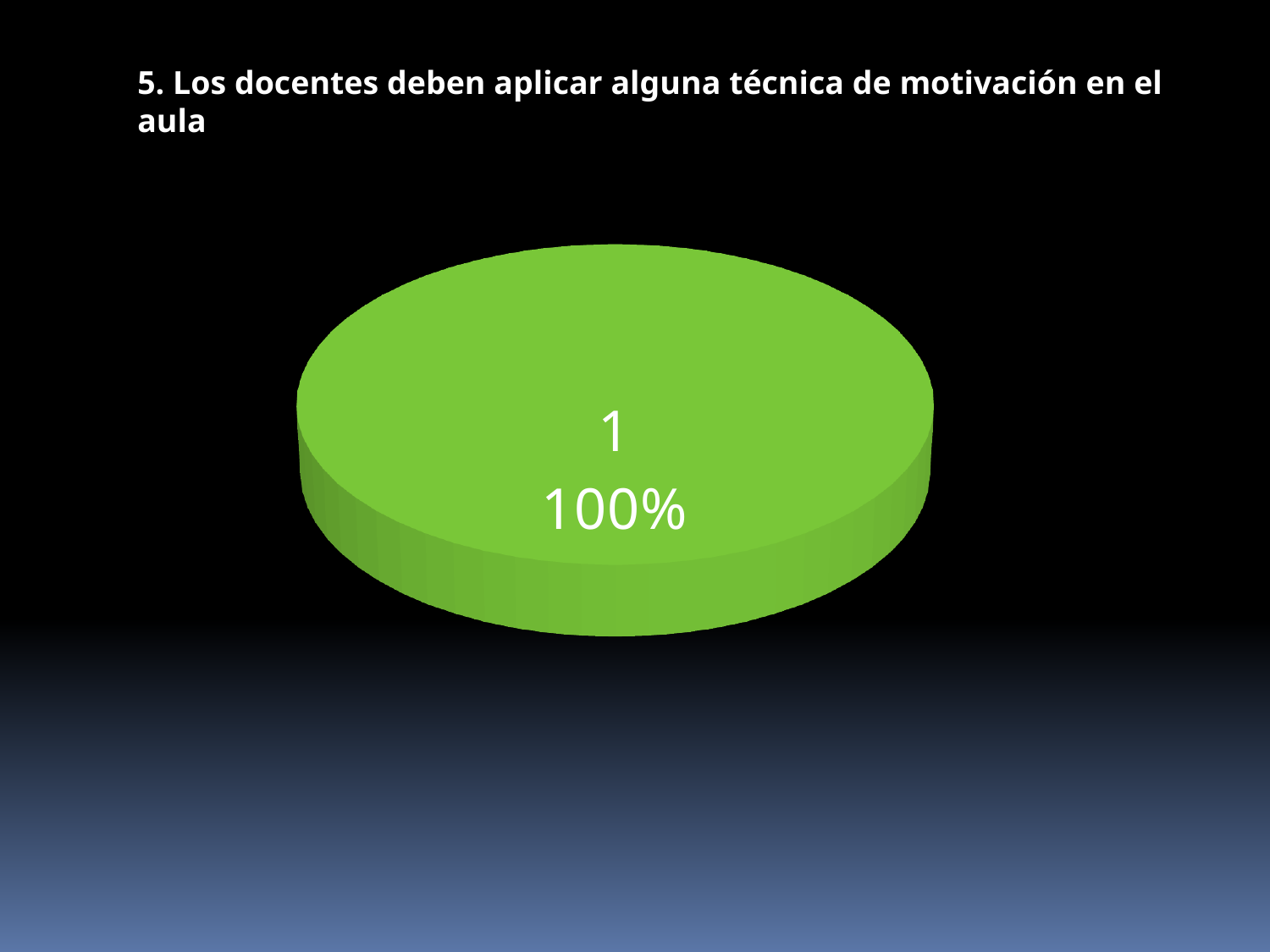
What percentage is printed on the pie chart's slice? 100% What is the title of the chart on the slide? 5. Los docentes deben aplicar alguna técnica de motivación en el aula What kind of chart is shown on the slide? pie chart How many slices does the pie chart have? 1 What category label is printed on the pie chart's slice? 1 What colour is the slice of the pie chart? green What share of the pie does the slice labelled 1 represent? 100%